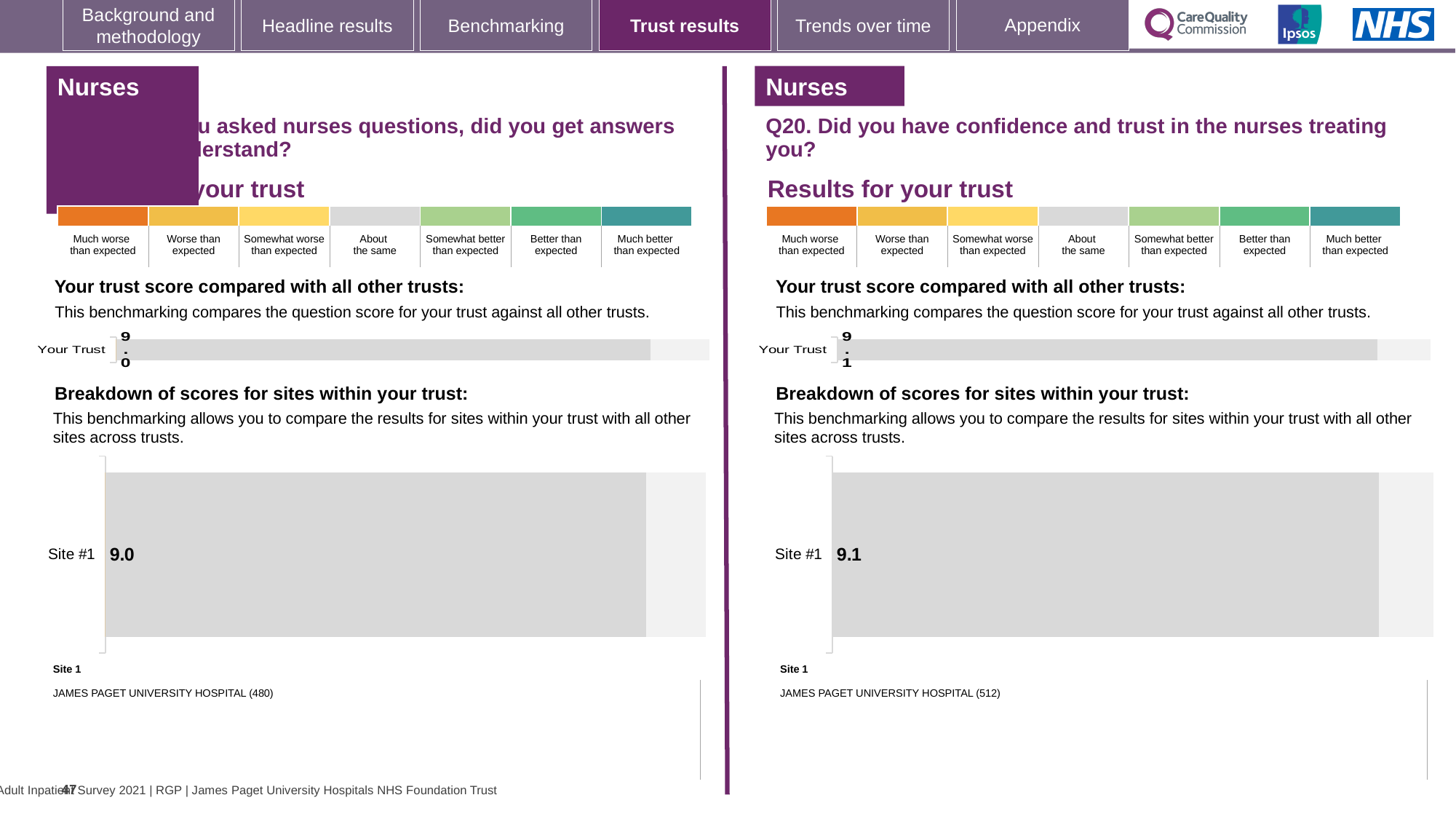
What is the difference between the Site #1 score on the right half (Q20) and the Site #1 score on the left half of the slide? 0.1 On the right half of the slide (Q20), which site name is listed as Site 1 below the chart? JAMES PAGET UNIVERSITY HOSPITAL (512) On the left half of the slide, what is the value shown for Your Trust in the trust score comparison chart? 9.0 How many sites are shown in the breakdown of scores chart on the left half of the slide? 1 On the left half of the slide, what is the score shown for Site #1 in the breakdown of scores for sites within your trust? 9.0 On the left half of the slide, what number appears in brackets after JAMES PAGET UNIVERSITY HOSPITAL in the Site 1 listing? 480 Which is larger: the Site #1 score on the left half of the slide or the Site #1 score on the right half (Q20)? Right half (Q20) How many sites are shown in the breakdown of scores chart on the right half of the slide (Q20)? 1 On the right half of the slide (Q20), what is the score shown for Site #1 in the breakdown of scores for sites within your trust? 9.1 What type of chart is used to show the Site #1 score on the right half of the slide (Q20)? Bar chart On the right half of the slide (Q20), what is the value shown for Your Trust in the trust score comparison chart? 9.1